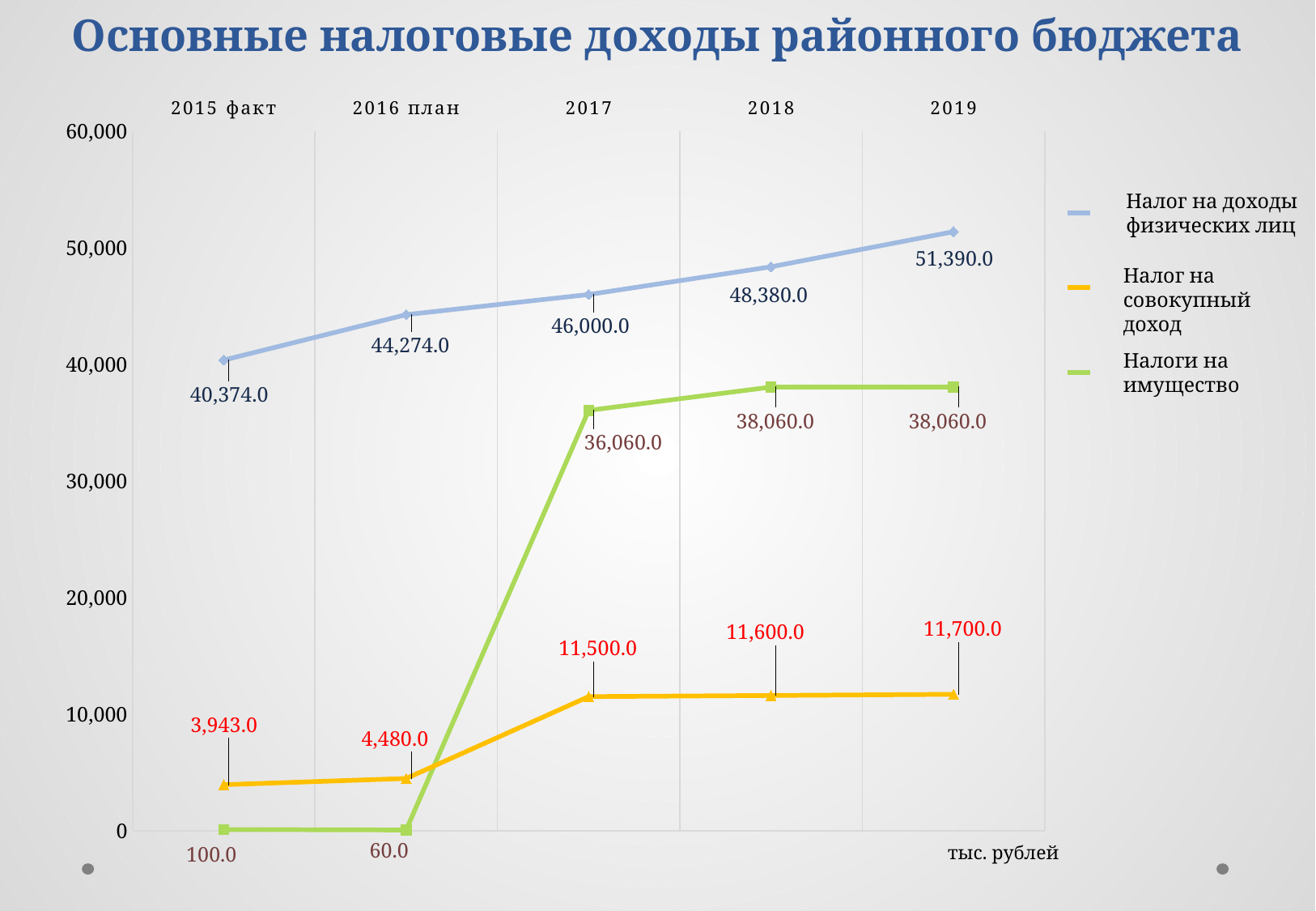
What is the value of Налог на доходы физических лиц for 2019? 51,390.0 What type of chart is shown on the slide? line chart What is the difference between Налог на доходы физических лиц in 2019 and in 2015 факт? 11,016.0 How many series does the legend list? 3 In which period is Налоги на имущество the lowest? 2016 план In which year is Налог на доходы физических лиц the highest? 2019 Does Налог на доходы физических лиц rise or fall from 2015 факт to 2019? rise What is the value of Налоги на имущество for 2015 факт? 100.0 Which is larger in 2017: Налоги на имущество or Налог на совокупный доход? Налоги на имущество How many time periods are shown on the x axis? 5 What is the value of Налог на совокупный доход for 2016 план? 4,480.0 What unit of measurement is indicated on the chart? тыс. рублей